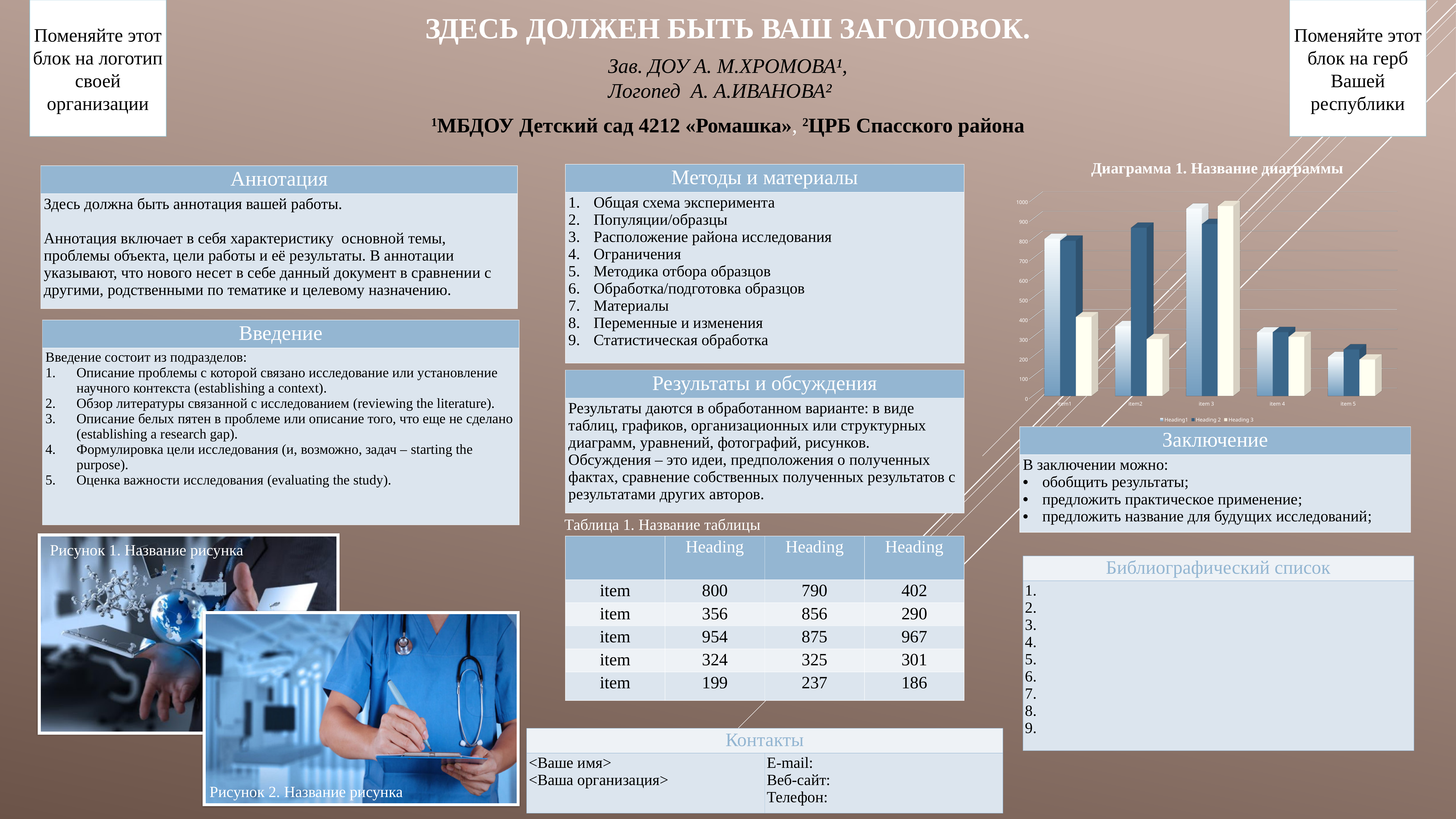
What is the title of the chart? Диаграмма 1. Название диаграммы What are the series names listed in the chart legend? Heading1, Heading 2, Heading 3 Which category has the lowest value for the Heading 2 series? item 5 For item1, which series has the larger value, Heading1 or Heading 3? Heading1 How many categories are shown on the x axis of the chart? 5 For item2, which series has the larger value, Heading1 or Heading 2? Heading 2 Which category has the highest value for the Heading1 series? item 3 Is the Heading 3 value for item 5 greater or less than 300? less What kind of chart is shown under "Диаграмма 1. Название диаграммы"? bar chart Which category has the lowest value for the Heading1 series? item 5 Which category has the highest value for the Heading 3 series? item 3 How many series does the chart legend list? 3